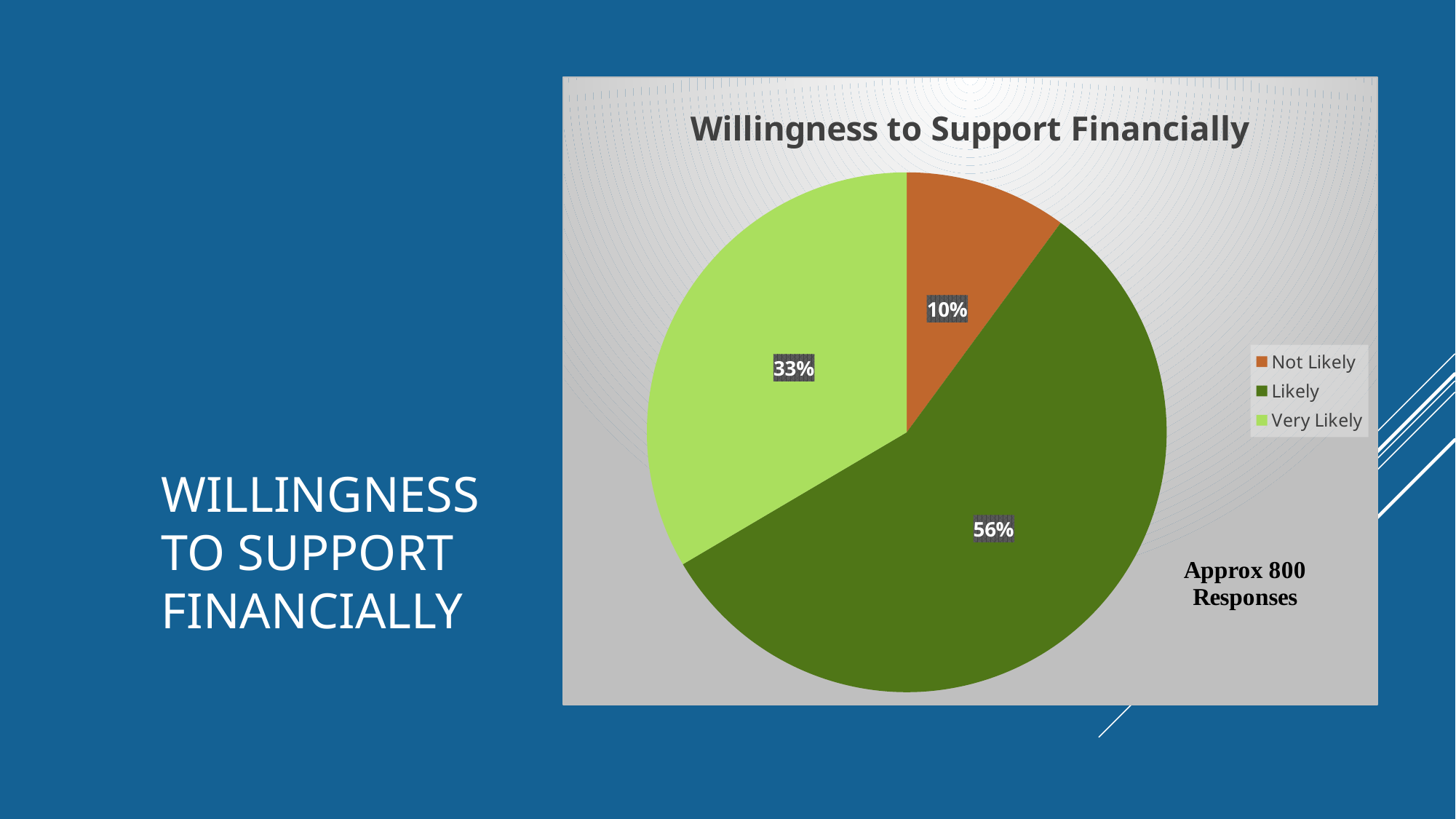
What is the combined share of 'Likely' and 'Very Likely'? 89% Which category has the largest share of the pie? Likely What percentage of responses are 'Not Likely'? 10% Approximately how many responses does the chart note? Approx 800 Responses How many categories does the pie chart show? 3 What kind of chart is shown on the slide? pie chart Which is larger, the share for 'Very Likely' or the share for 'Not Likely'? Very Likely Which category has the smallest share of the pie? Not Likely What percentage of responses are 'Likely'? 56% What is the difference in percentage points between 'Likely' and 'Very Likely'? 23 What percentage of responses are 'Very Likely'? 33% What is the title of the chart? Willingness to Support Financially